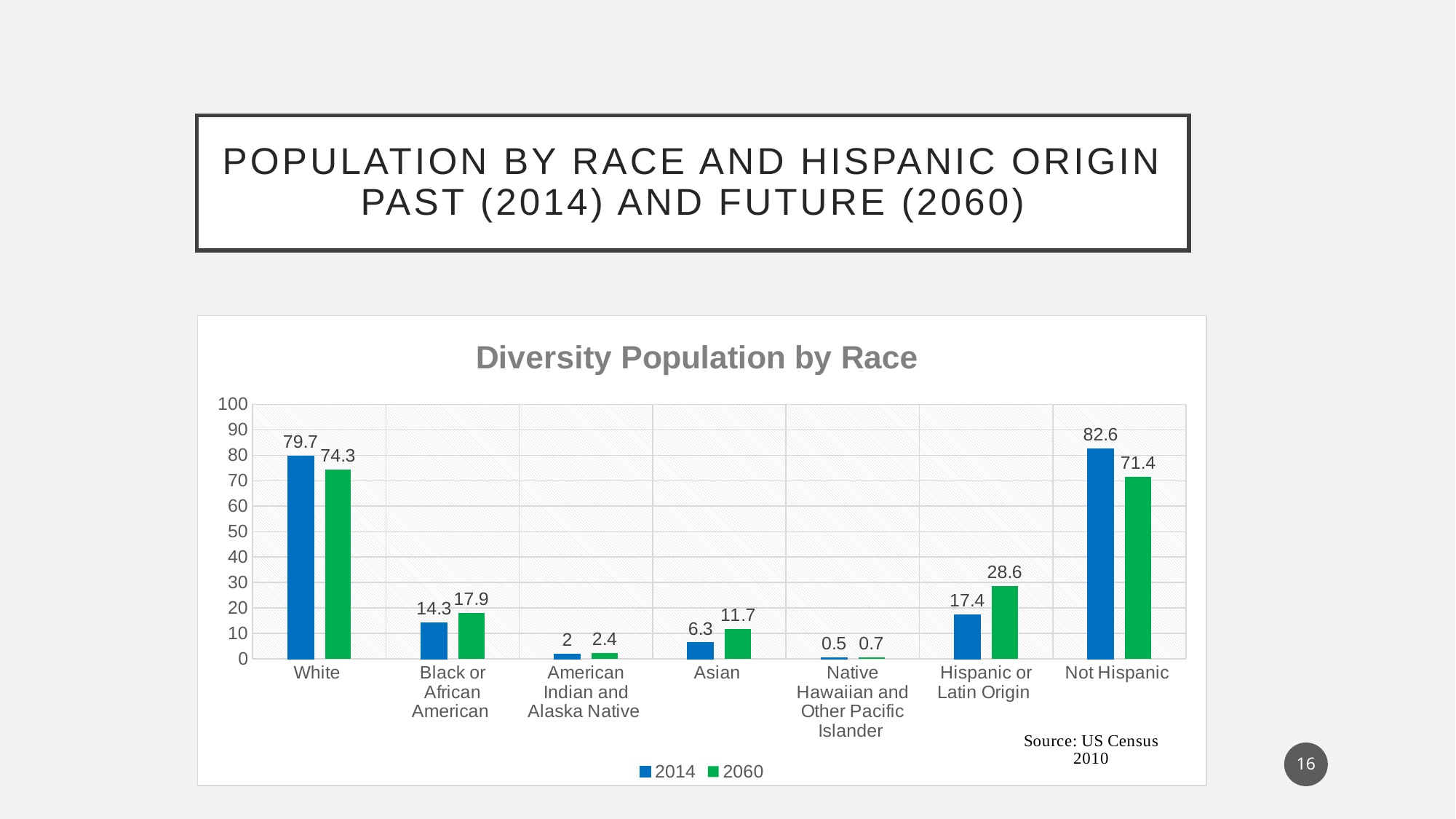
Which category has the highest 2014 value? Not Hispanic What is the 2014 value for White? 79.7 What is the title of the chart? Diversity Population by Race How many categories are shown on the x axis? 7 Which is larger for Black or African American: the 2014 value or the 2060 value? 2060 What kind of chart is shown? bar chart How many series does the legend list? 2 Is the 2060 value for White greater or less than 80? less What is the 2060 value for Hispanic or Latin Origin? 28.6 What is the difference between the 2014 and 2060 values for Not Hispanic? 11.2 Which category has the lowest 2060 value? Native Hawaiian and Other Pacific Islander What is the 2060 value for Asian? 11.7